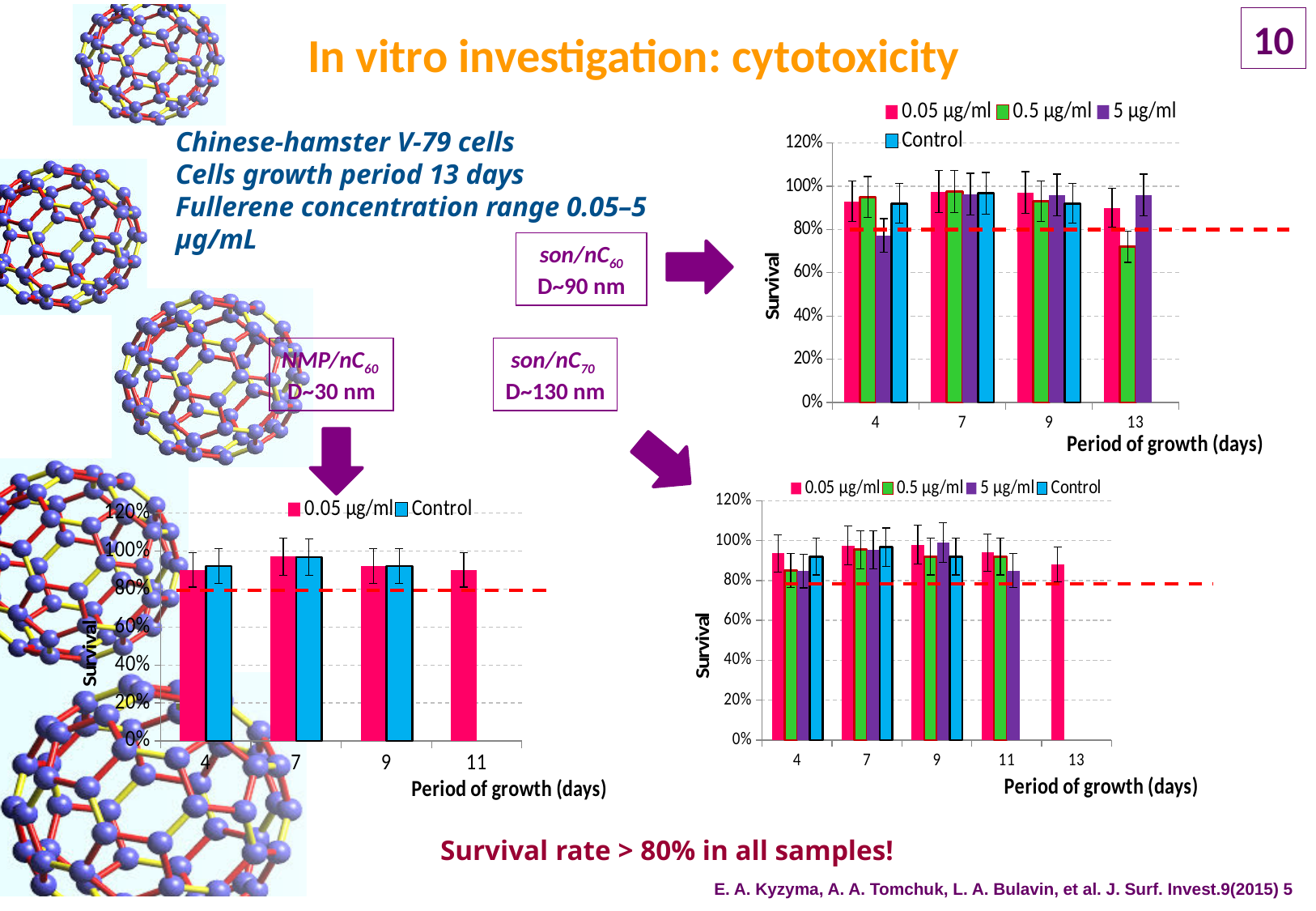
How many series does the legend of the bottom-left chart list? 2 In the bottom-right chart, is the survival value for Control at 9 days greater or less than 60%? greater What kind of chart is the top-right chart on the slide? bar chart In the bottom-right chart, is the survival value for 0.05 µg/ml at 13 days greater or less than 80%? greater What is the label of the y axis on the bottom-left chart? Survival How many period-of-growth categories are shown on the x axis of the top-right chart? 4 How many period-of-growth categories are shown on the x axis of the bottom-right chart? 5 In the top-right chart, is the survival value for 0.05 µg/ml at 7 days greater or less than 80%? greater How many series does the legend of the top-right chart list? 4 What is the label of the x axis on the top-right chart? Period of growth (days)